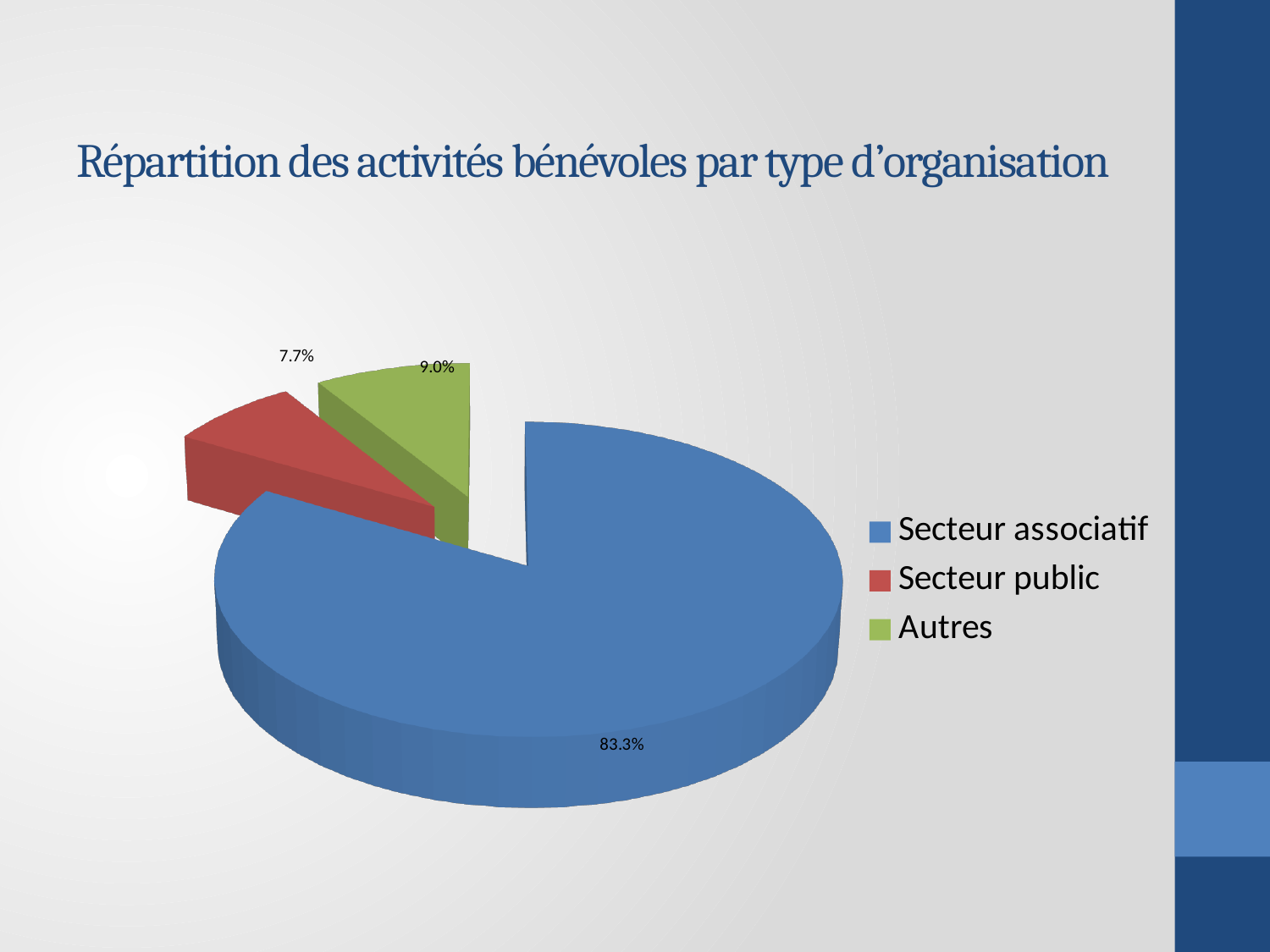
What is the title of the chart? Répartition des activités bénévoles par type d'organisation What is the difference in percentage points between Secteur associatif and Autres? 74.3 What is the difference in percentage points between Autres and Secteur public? 1.3 How many categories are shown in the pie chart? 3 Which category has the largest slice of the pie? Secteur associatif Which is larger, the slice for Secteur public or the slice for Autres? Autres What kind of chart is shown on the slide? Pie chart What colour is the slice for Secteur public? Red What share of the pie does Secteur public represent? 7.7% What share of the pie does Secteur associatif represent? 83.3% Which category has the smallest slice of the pie? Secteur public What share of the pie does Autres represent? 9.0%